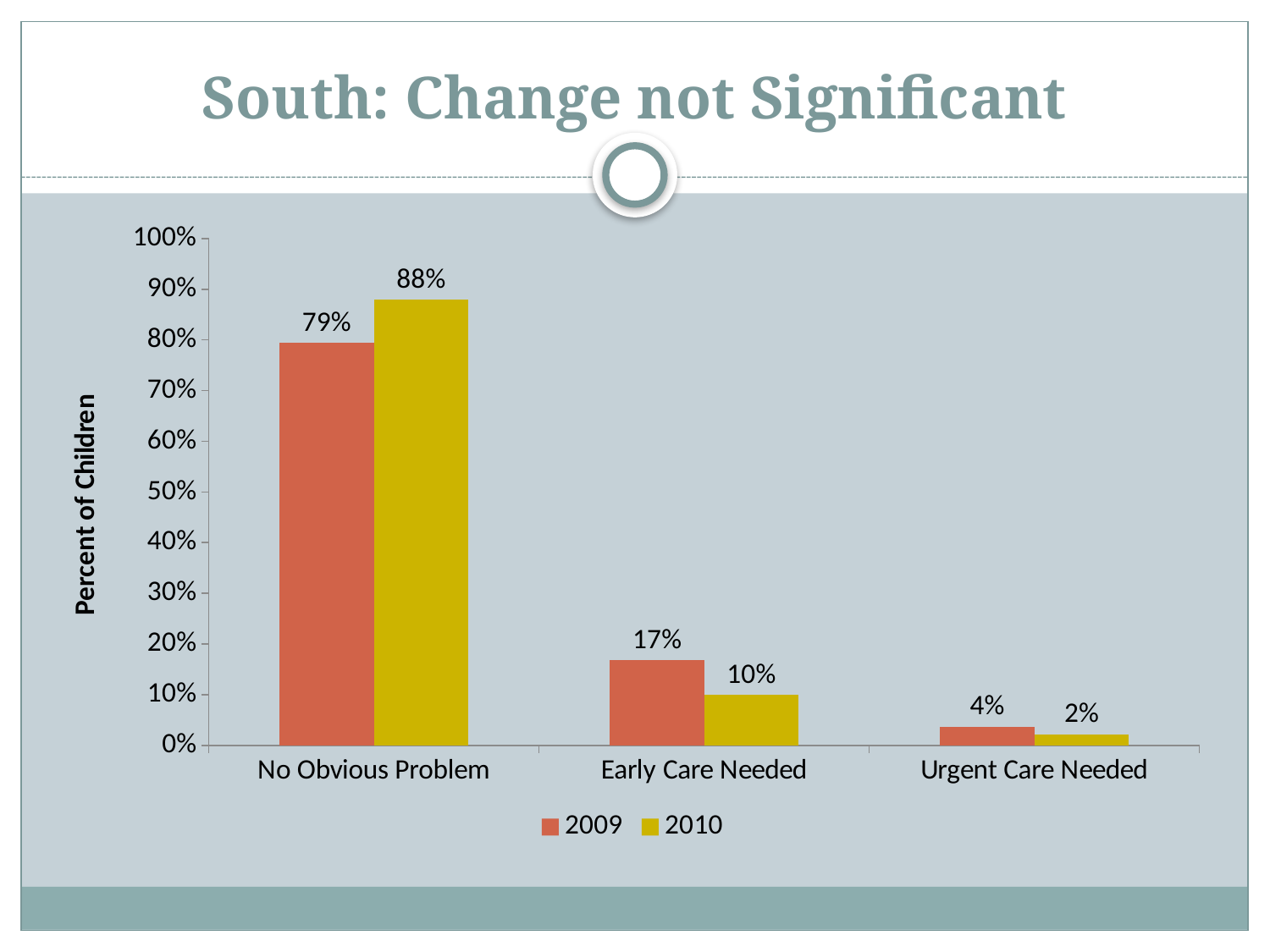
What is the 2010 value for Urgent Care Needed? 2% What is the 2010 value for Early Care Needed? 10% What is the difference between the 2010 and 2009 values for No Obvious Problem? 9% How many categories are shown on the x axis? 3 Which is larger for Early Care Needed, the 2009 value or the 2010 value? 2009 What is the label on the vertical axis? Percent of Children How many series does the legend list? 2 Which category has the highest 2010 value? No Obvious Problem What is the difference between the 2009 and 2010 values for Early Care Needed? 7% What is the 2009 value for No Obvious Problem? 79% Which category has the lowest 2009 value? Urgent Care Needed What kind of chart is shown on the slide? Bar chart